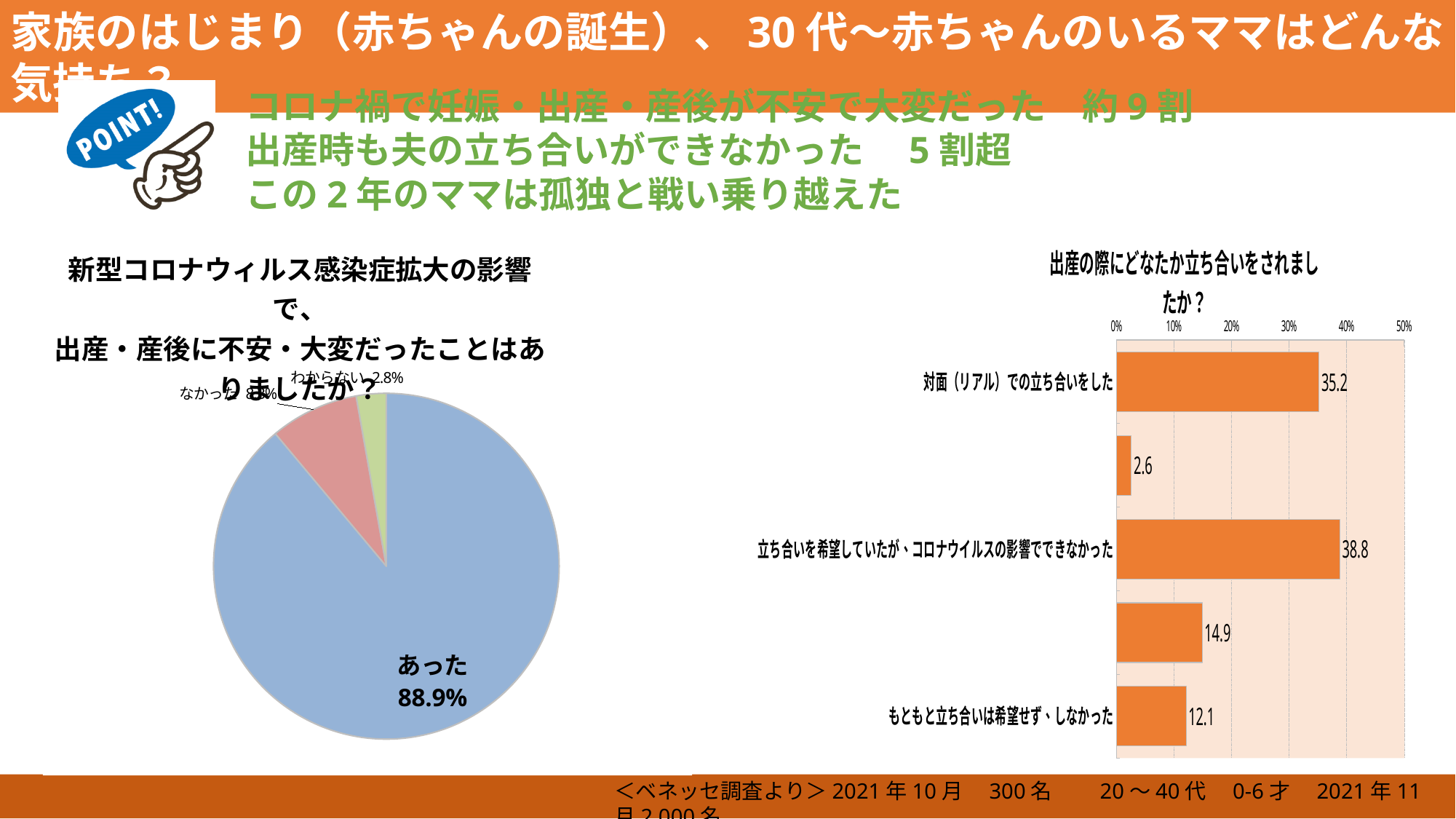
In the bar chart on the right, what is the difference between the values for 立ち合いを希望していたが、コロナウイルスの影響でできなかった and 対面（リアル）での立ち合いをした? 3.6 In the bar chart on the right, what is the value for 立ち合いを希望していたが、コロナウイルスの影響でできなかった? 38.8 In the bar chart on the right, what is the value for 対面（リアル）での立ち合いをした? 35.2 How many bars are shown in the bar chart on the right? 5 In the pie chart on the left, what share of respondents answered わからない? 2.8% What type of chart is the chart on the right of the slide (出産の際にどなたか立ち合いをされましたか？)? bar chart In the pie chart on the left, what share of respondents answered あった? 88.9% In the pie chart on the left, which slice is the largest? あった What type of chart is the chart on the left of the slide? pie chart How many slices does the pie chart on the left have? 3 In the bar chart on the right, which category has the highest value? 立ち合いを希望していたが、コロナウイルスの影響でできなかった In the bar chart on the right, what is the value for もともと立ち合いは希望せず、しなかった? 12.1